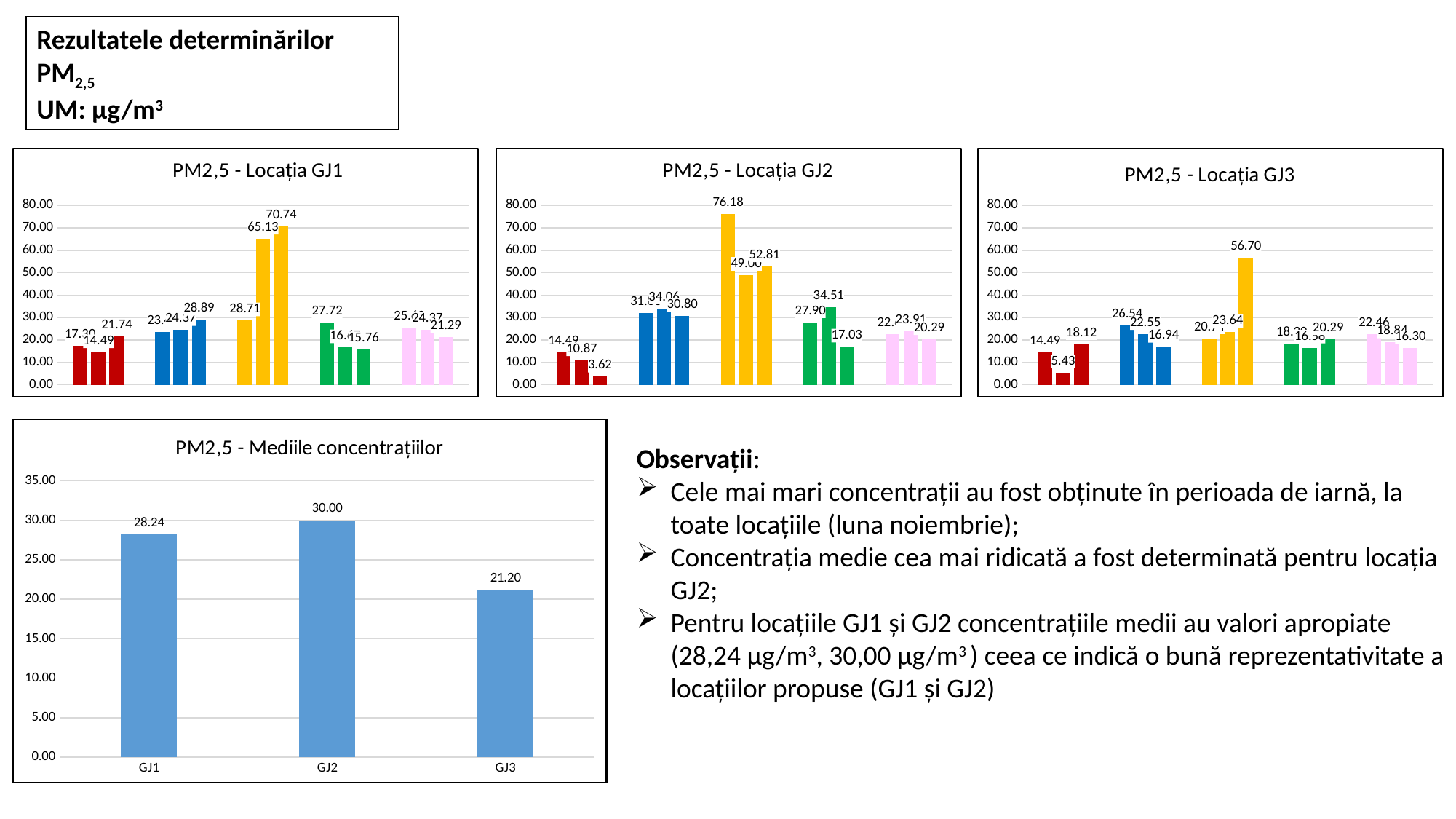
What kind of chart is 'PM2,5 - Mediile concentrațiilor'? bar chart In the chart 'PM2,5 - Locația GJ2', what is the highest value shown? 76.18 In the chart 'PM2,5 - Locația GJ2', what is the lowest value shown? 3.62 In the chart 'PM2,5 - Mediile concentrațiilor', what is the value for GJ1? 28.24 In the chart 'PM2,5 - Locația GJ1', what is the highest value shown? 70.74 In the chart 'PM2,5 - Mediile concentrațiilor', what is the value for GJ3? 21.20 In the chart 'PM2,5 - Mediile concentrațiilor', how many locations are shown on the x axis? 3 In the chart 'PM2,5 - Locația GJ3', what is the lowest value shown? 5.43 In the chart 'PM2,5 - Mediile concentrațiilor', which location has the highest value? GJ2 In the chart 'PM2,5 - Mediile concentrațiilor', which location has the lowest value? GJ3 In the chart 'PM2,5 - Mediile concentrațiilor', what is the difference between the values for GJ2 and GJ1? 1.76